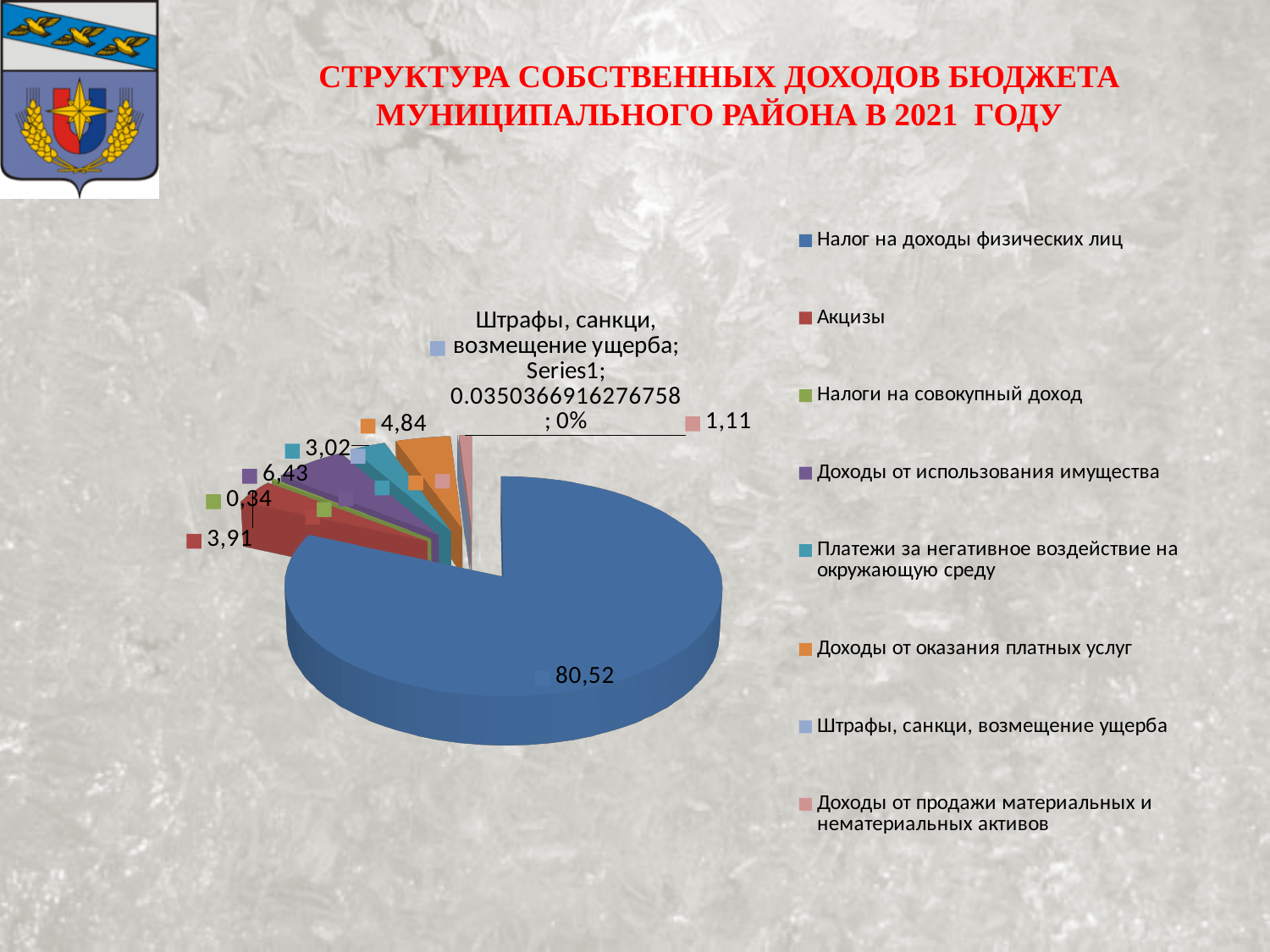
What value is shown for Доходы от продажи материальных и нематериальных активов? 1,11 What value is shown for Доходы от оказания платных услуг? 4,84 Which is larger: Доходы от использования имущества or Доходы от оказания платных услуг? Доходы от использования имущества What value is shown for Доходы от использования имущества? 6,43 How many entries does the legend list? 8 What is the difference between the values for Доходы от использования имущества and Платежи за негативное воздействие на окружающую среду? 3,41 What is the title of the slide? СТРУКТУРА СОБСТВЕННЫХ ДОХОДОВ БЮДЖЕТА МУНИЦИПАЛЬНОГО РАЙОНА В 2021 ГОДУ What value is shown for Налог на доходы физических лиц? 80,52 What kind of chart is shown on the slide? Pie chart What value is shown for Платежи за негативное воздействие на окружающую среду? 3,02 What value is shown for Акцизы? 3,91 Which category has the largest slice of the pie? Налог на доходы физических лиц